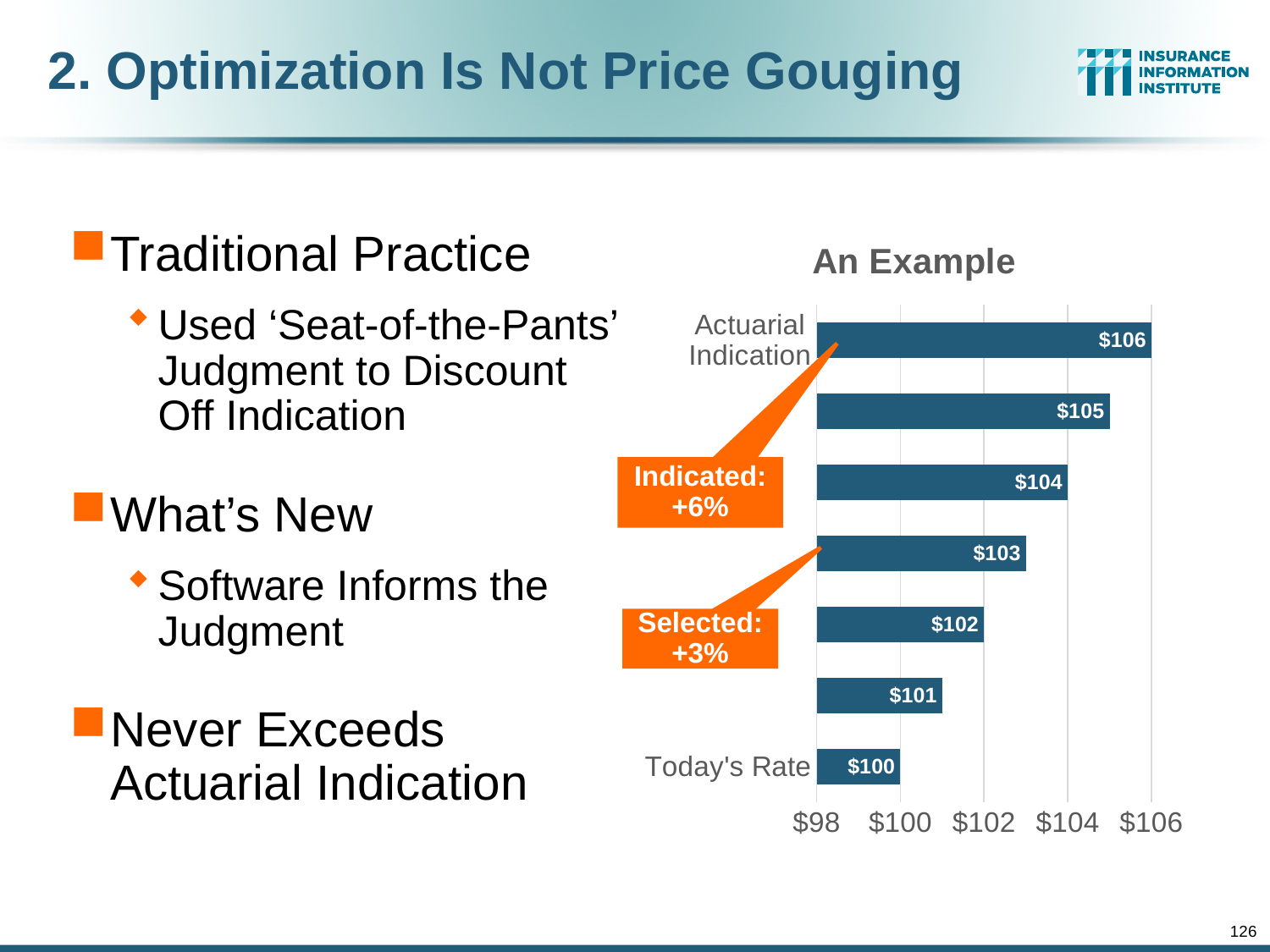
Which category has the longest bar in the "An Example" chart? Actuarial Indication What type of chart is "An Example"? Bar chart What is the highest data label shown on any bar in the "An Example" chart? $106 What percentage does the "Selected" callout on the chart show? +3% What is the difference between the Actuarial Indication value and the Today's Rate value in the "An Example" chart? $6 How many bars are plotted in the "An Example" chart? 7 Which is larger in the "An Example" chart: the Actuarial Indication bar or the Today's Rate bar? Actuarial Indication Which category has the shortest bar in the "An Example" chart? Today's Rate What is the value of the Actuarial Indication bar in the "An Example" chart? $106 Is the value of the Today's Rate bar greater or less than $102 in the "An Example" chart? less What is the value of the Today's Rate bar in the "An Example" chart? $100 What is the title of the chart on the slide? An Example